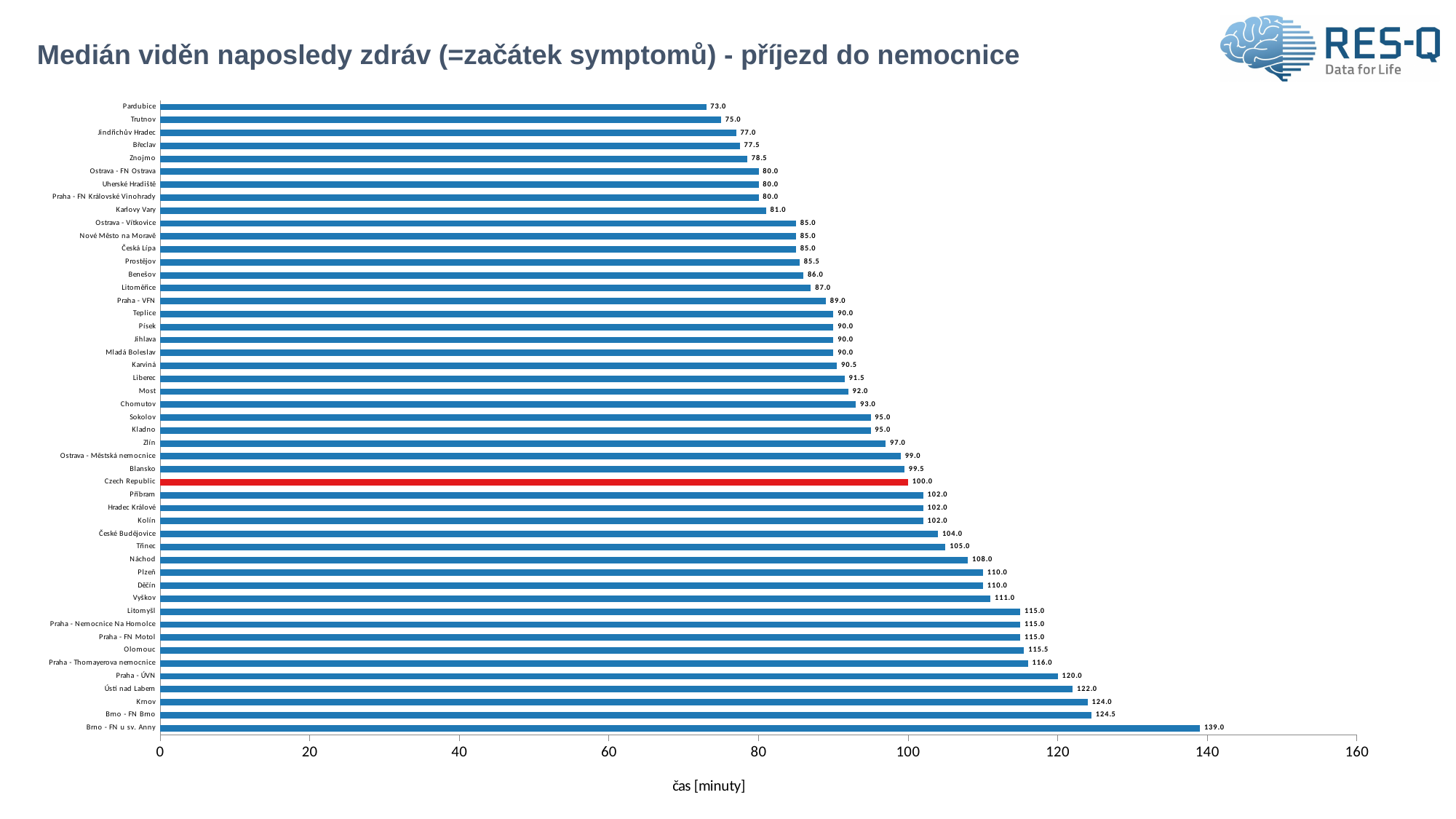
Is the value for Krnov greater or less than 120? greater What is the value for Brno - FN u sv. Anny? 139.0 What is the difference between the values for Brno - FN u sv. Anny and Czech Republic? 39.0 What is the value for Czech Republic? 100.0 Which bar is highlighted in red? Czech Republic Which category has the lowest value? Pardubice What is the value for Olomouc? 115.5 Which is larger, the value for Plzeň or the value for Náchod? Plzeň What kind of chart is shown on the slide? bar chart What is the label of the horizontal axis? čas [minuty] Which category has the highest value? Brno - FN u sv. Anny What is the value for Pardubice? 73.0